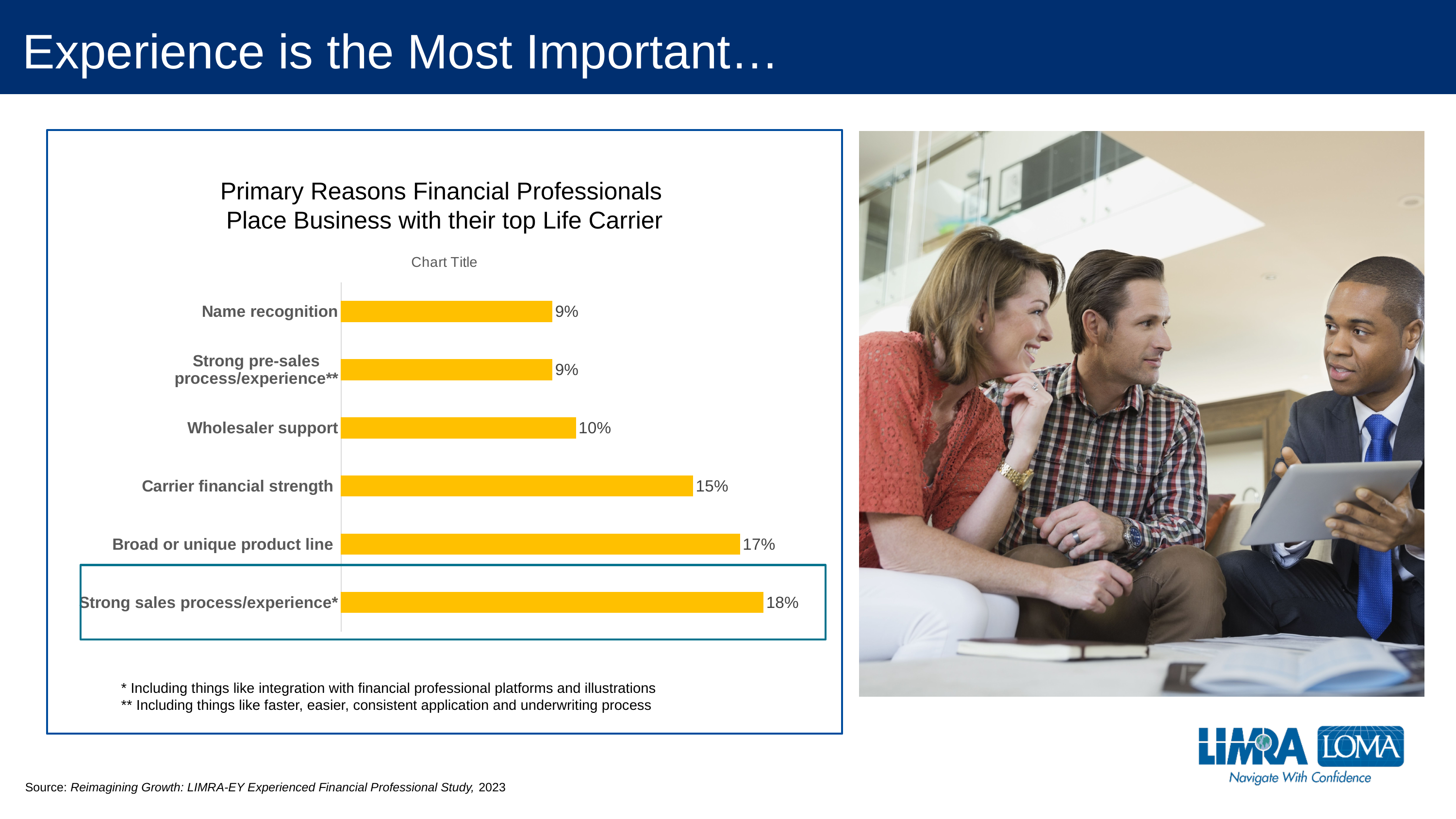
Which category has the highest value? Strong sales process/experience* What is the value for Carrier financial strength? 15% What is the value for Wholesaler support? 10% What is the title of the chart? Primary Reasons Financial Professionals Place Business with their top Life Carrier Which is larger, Wholesaler support or Carrier financial strength? Carrier financial strength What is the difference between Broad or unique product line and Carrier financial strength? 2% How many categories are shown in the chart? 6 What colour are the bars in the chart? Yellow What kind of chart is shown? Bar chart What is the value for Broad or unique product line? 17% What is the value for Strong sales process/experience*? 18% What is the difference between Strong sales process/experience* and Name recognition? 9%